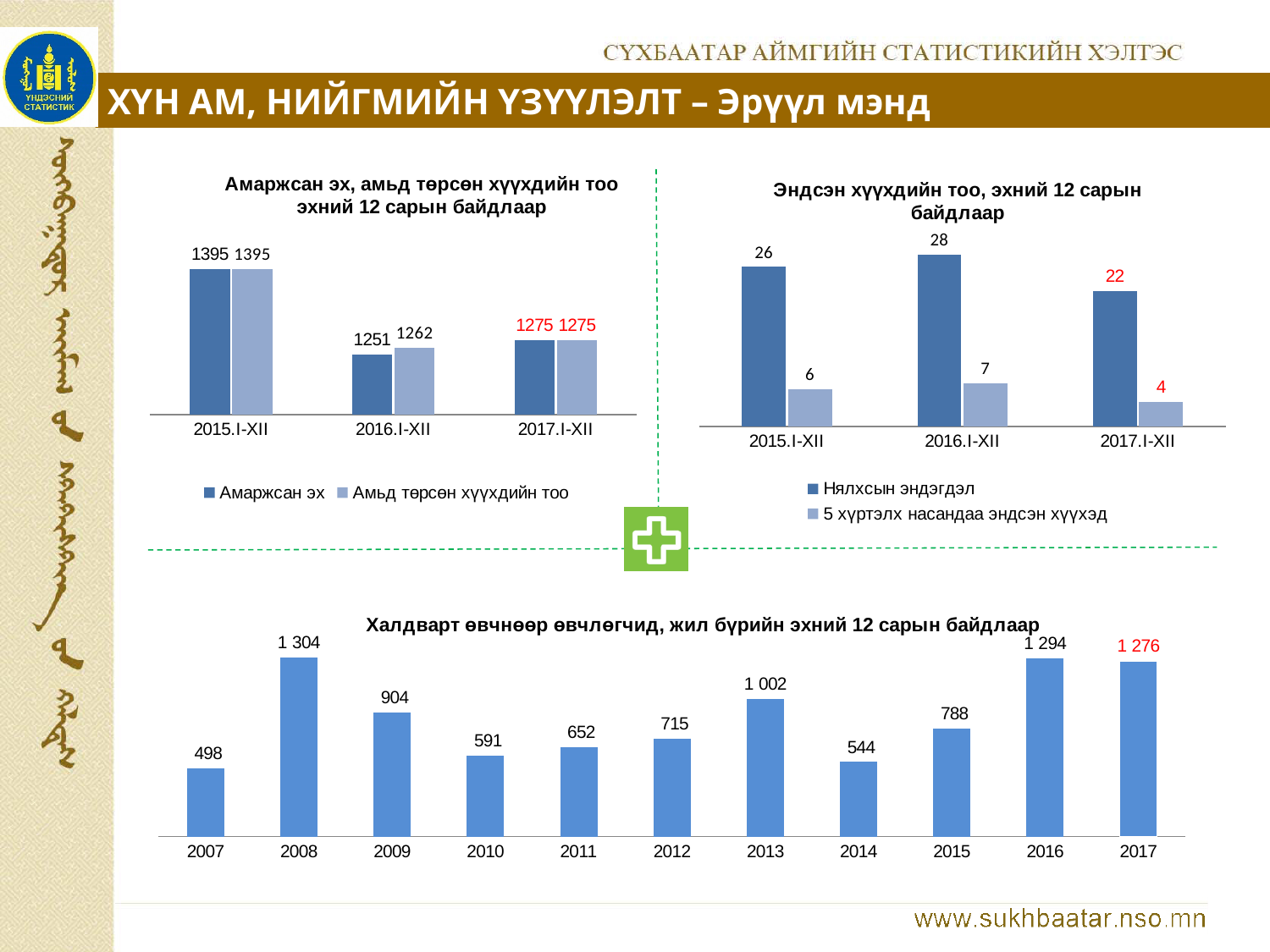
In the top-right chart (Эндсэн хүүхдийн тоо), what is the value for Нялхсын эндэгдэл in 2016.I-XII? 28 In the top-right chart (Эндсэн хүүхдийн тоо), which period has the lowest value for Нялхсын эндэгдэл? 2017.I-XII In the bottom chart (Халдварт өвчнөөр өвчлөгчид), which year has the highest value? 2008 In the top-left chart (Амаржсан эх, амьд төрсөн хүүхдийн тоо), what is the difference between the Амаржсан эх values for 2015.I-XII and 2017.I-XII? 120 In the bottom chart (Халдварт өвчнөөр өвчлөгчид), how many years are shown on the x axis? 11 In the bottom chart (Халдварт өвчнөөр өвчлөгчид), which is larger, the value for 2012 or the value for 2015? 2015 In the top-left chart (Амаржсан эх, амьд төрсөн хүүхдийн тоо), what is the value for Амьд төрсөн хүүхдийн тоо in 2016.I-XII? 1262 In the top-left chart (Амаржсан эх, амьд төрсөн хүүхдийн тоо), how many series does the legend list? 2 In the bottom chart (Халдварт өвчнөөр өвчлөгчид), what is the value for 2013? 1 002 In the top-left chart (Амаржсан эх, амьд төрсөн хүүхдийн тоо), what is the value for Амаржсан эх in 2016.I-XII? 1251 In the top-right chart (Эндсэн хүүхдийн тоо), what is the value for 5 хүртэлх насандаа эндсэн хүүхэд in 2017.I-XII? 4 In the bottom chart (Халдварт өвчнөөр өвчлөгчид), which year has the lowest value? 2007